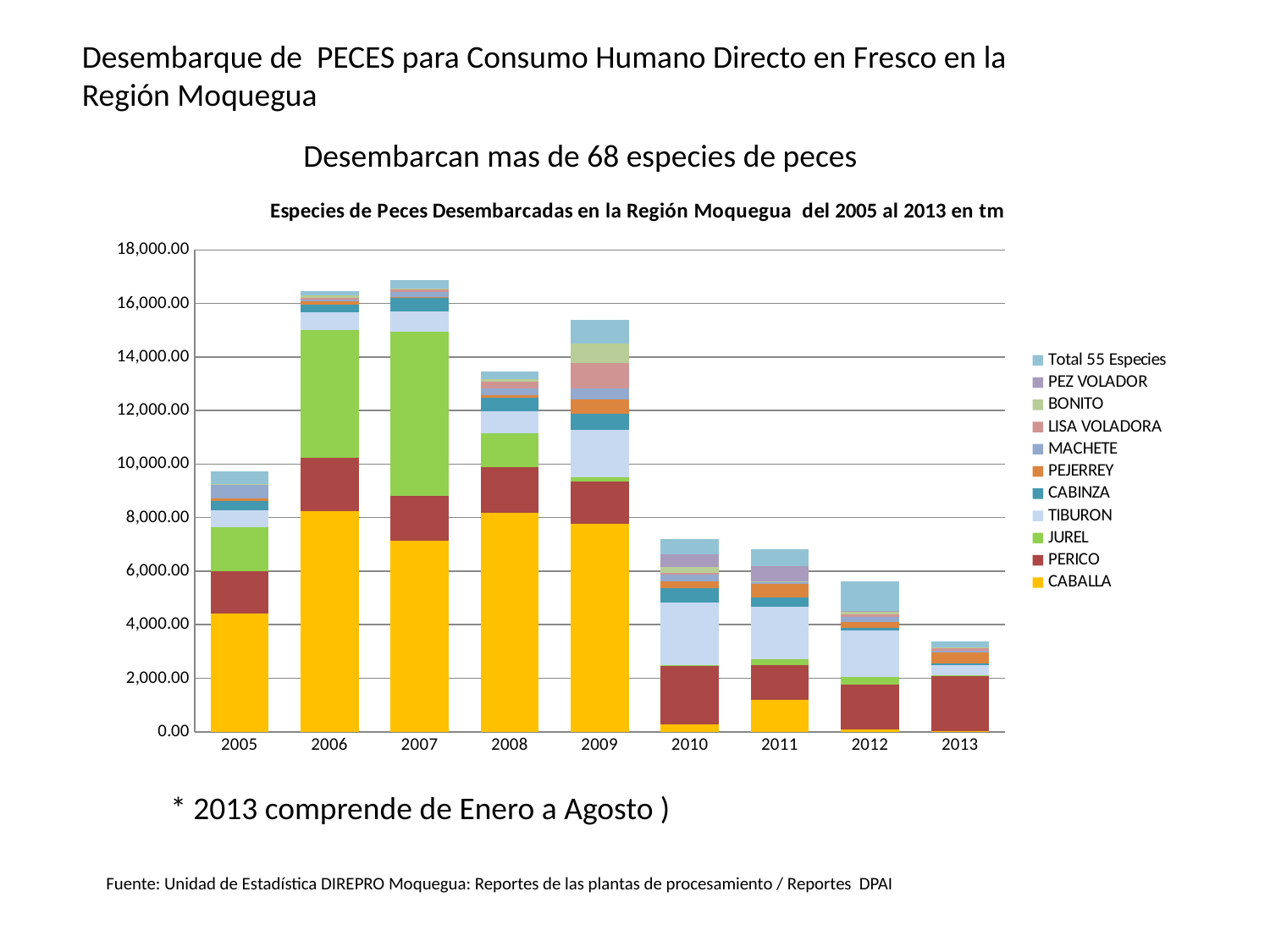
Which series is shown in yellow at the bottom of each stacked bar? CABALLA Which year has the lowest total landings in the chart? 2013 What kind of chart is shown on the slide? Stacked bar chart Is the total bar height for 2009 greater or less than 14,000.00? greater Do the total bar heights rise or fall from 2009 to 2013? Fall Which year has the larger total bar, 2012 or 2013? 2012 How many years are shown on the x axis of the chart? 9 How many series does the chart's legend list? 11 Is the total bar height for 2010 greater or less than 6,000.00? greater Is the total bar height for 2005 greater or less than 10,000.00? less Which year has the larger total bar, 2008 or 2009? 2009